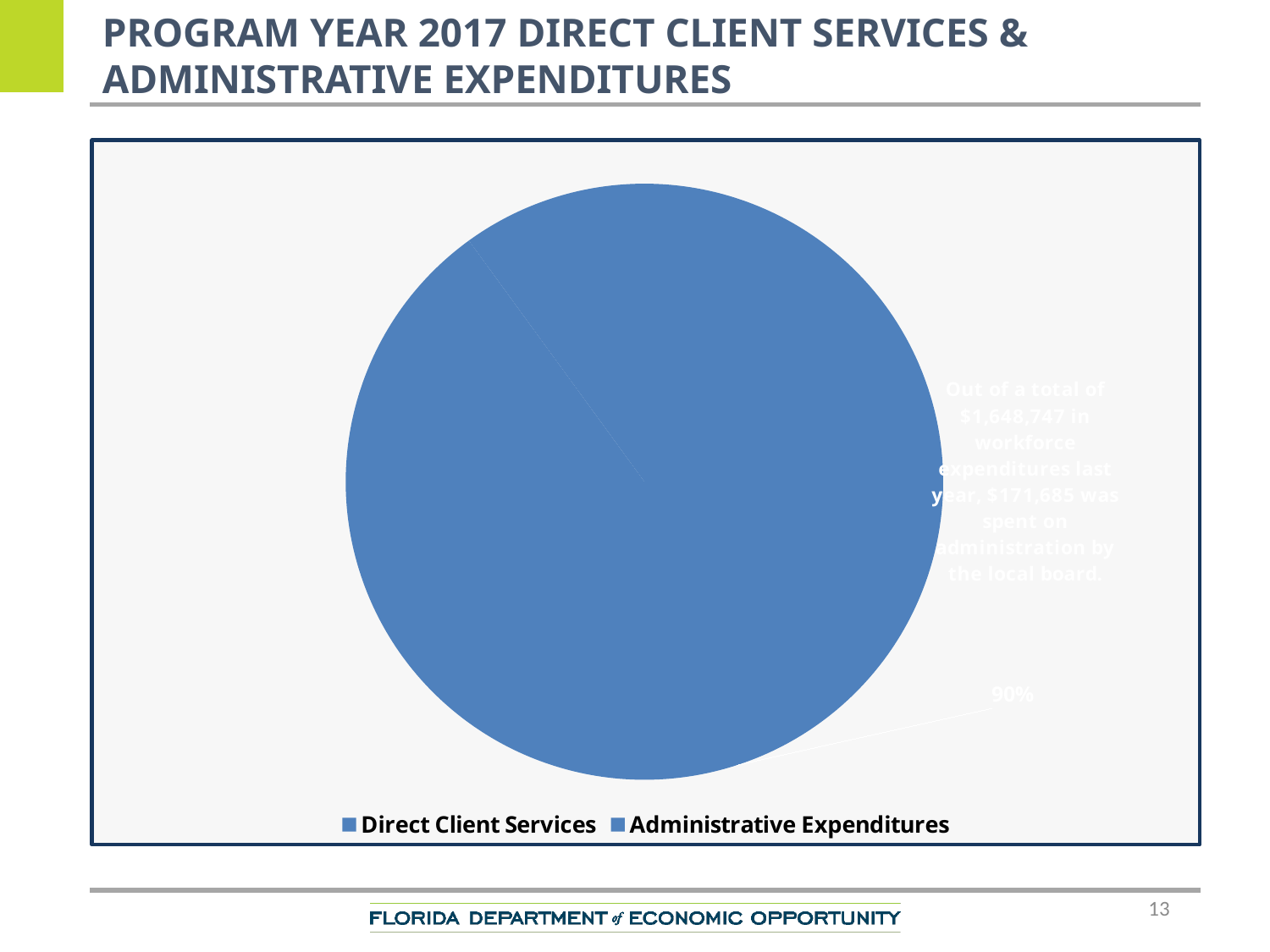
What percentage label is shown on the pie chart for the Direct Client Services slice? 90% Which category has the largest slice in the pie chart? Direct Client Services What is the title of the slide containing the pie chart? Program Year 2017 Direct Client Services & Administrative Expenditures Which slice of the pie chart is larger, Direct Client Services or Administrative Expenditures? Direct Client Services Which category has the smallest slice in the pie chart? Administrative Expenditures How many entries does the legend of the pie chart list? 2 What kind of chart is shown on the slide? pie chart How many categories does the pie chart show? 2 What are the two legend entries of the pie chart? Direct Client Services and Administrative Expenditures